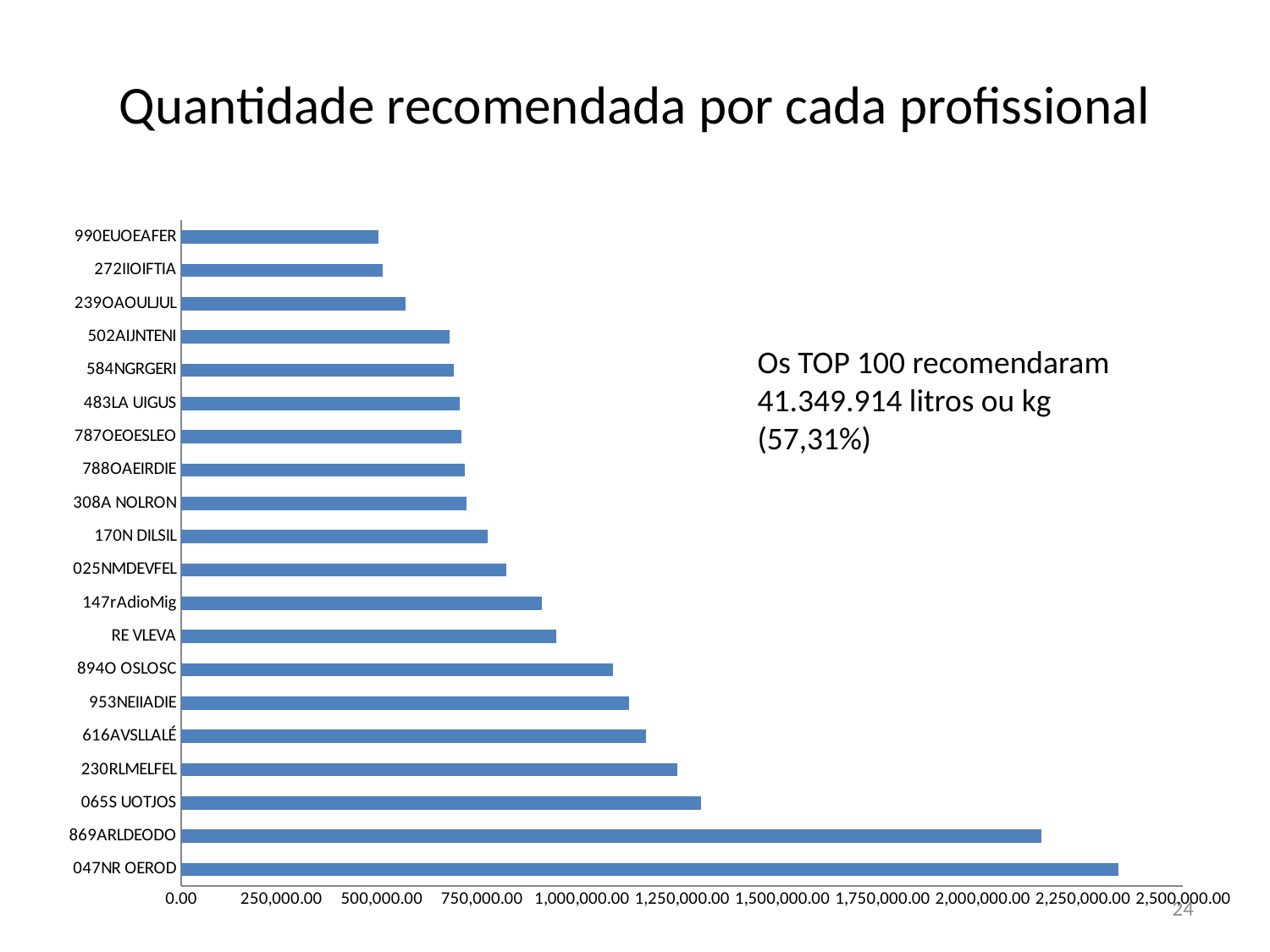
What is the title of the chart? Quantidade recomendada por cada profissional Is the value for 894O OSLOSC greater or less than 1,000,000.00? greater What is the highest tick value shown on the horizontal axis? 2,500,000.00 Is the value for 147rAdioMig greater or less than 1,000,000.00? less Which has a larger value, 869ARLDEODO or 065S UOTJOS? 869ARLDEODO Which has a larger value, 616AVSLLALÉ or RE VLEVA? 616AVSLLALÉ Which professional has the highest recommended quantity? 047NR OEROD What kind of chart is shown on the slide? bar chart Is the value for 239OAOULJUL greater or less than 750,000.00? less How many professionals (categories) are plotted in the chart? 20